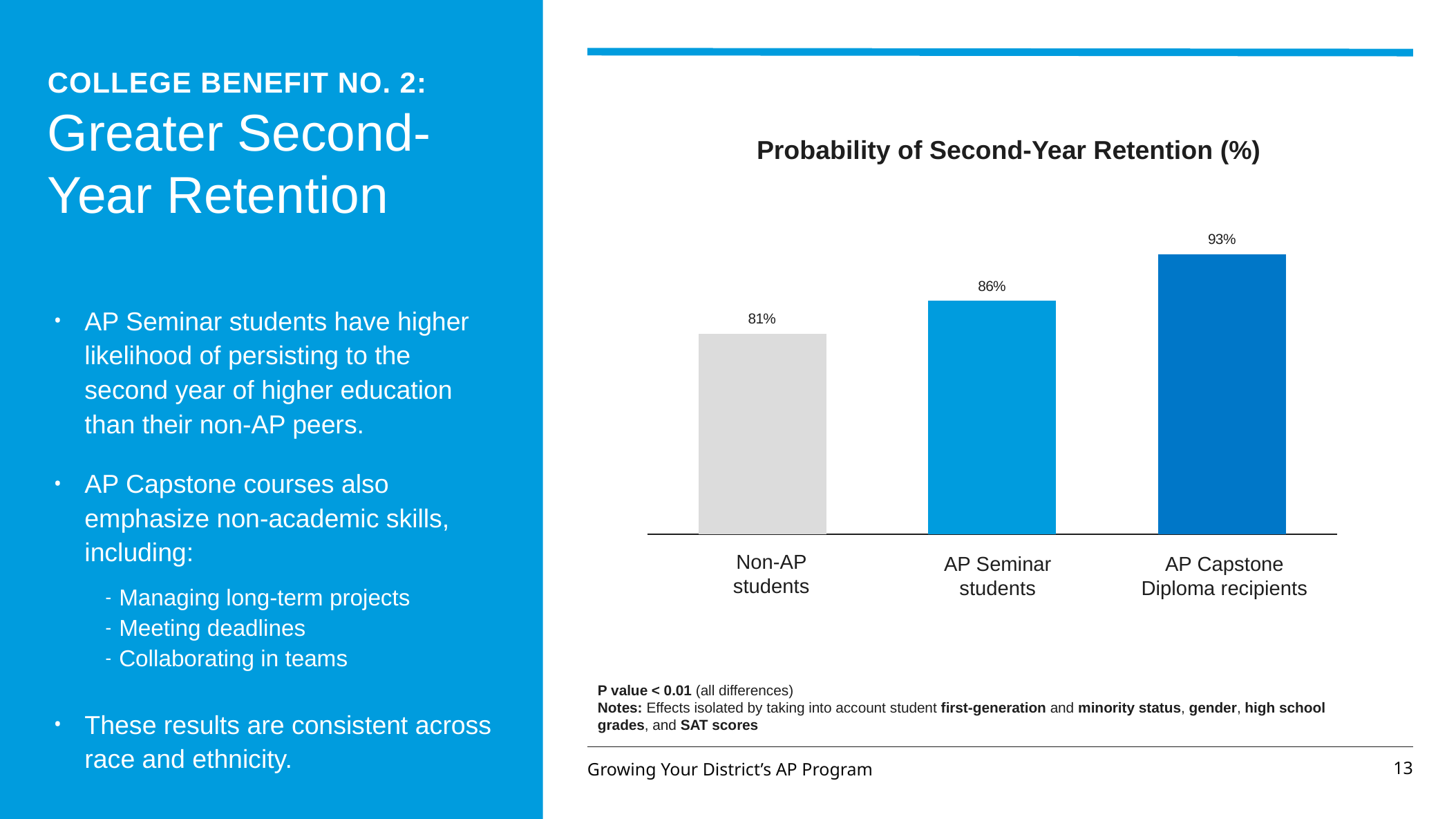
What is the difference in second-year retention probability between AP Capstone Diploma recipients and Non-AP students? 12% What is the difference in second-year retention probability between AP Seminar students and Non-AP students? 5% What is the probability of second-year retention for Non-AP students? 81% How many categories are shown in the chart? 3 What is the title of the chart? Probability of Second-Year Retention (%) What is the probability of second-year retention for AP Capstone Diploma recipients? 93% What type of chart is shown on the slide? Bar chart Which category has the lowest probability of second-year retention? Non-AP students Which category has the highest probability of second-year retention? AP Capstone Diploma recipients Do the values rise or fall from left to right across the categories? Rise Which has a higher probability of second-year retention: AP Seminar students or AP Capstone Diploma recipients? AP Capstone Diploma recipients What is the probability of second-year retention for AP Seminar students? 86%